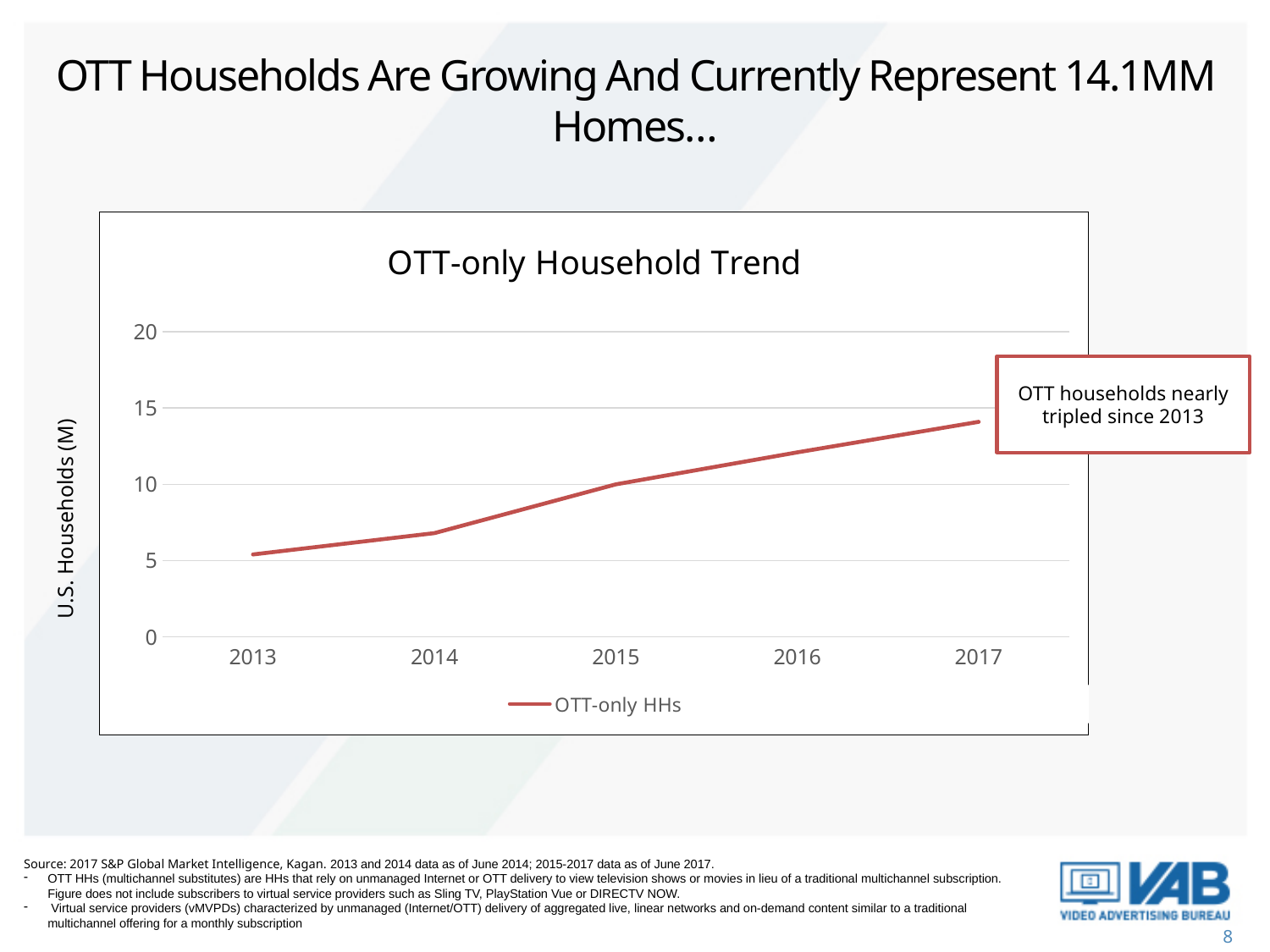
Is the value for OTT-only HHs in 2013 greater or less than 10? less What kind of chart is shown on the slide? line chart What is the label on the vertical axis of the chart? U.S. Households (M) What is the title of the chart? OTT-only Household Trend Is the value for OTT-only HHs in 2017 greater or less than 10? greater How many years are plotted along the x axis? 5 Is the value for OTT-only HHs in 2017 greater or less than 15? less Which year has the highest value for OTT-only HHs? 2017 How many series does the legend list? 1 Do the values for OTT-only HHs rise or fall from 2013 to 2017? rise Which year has the lowest value for OTT-only HHs? 2013 Which year has the larger value for OTT-only HHs, 2014 or 2016? 2016